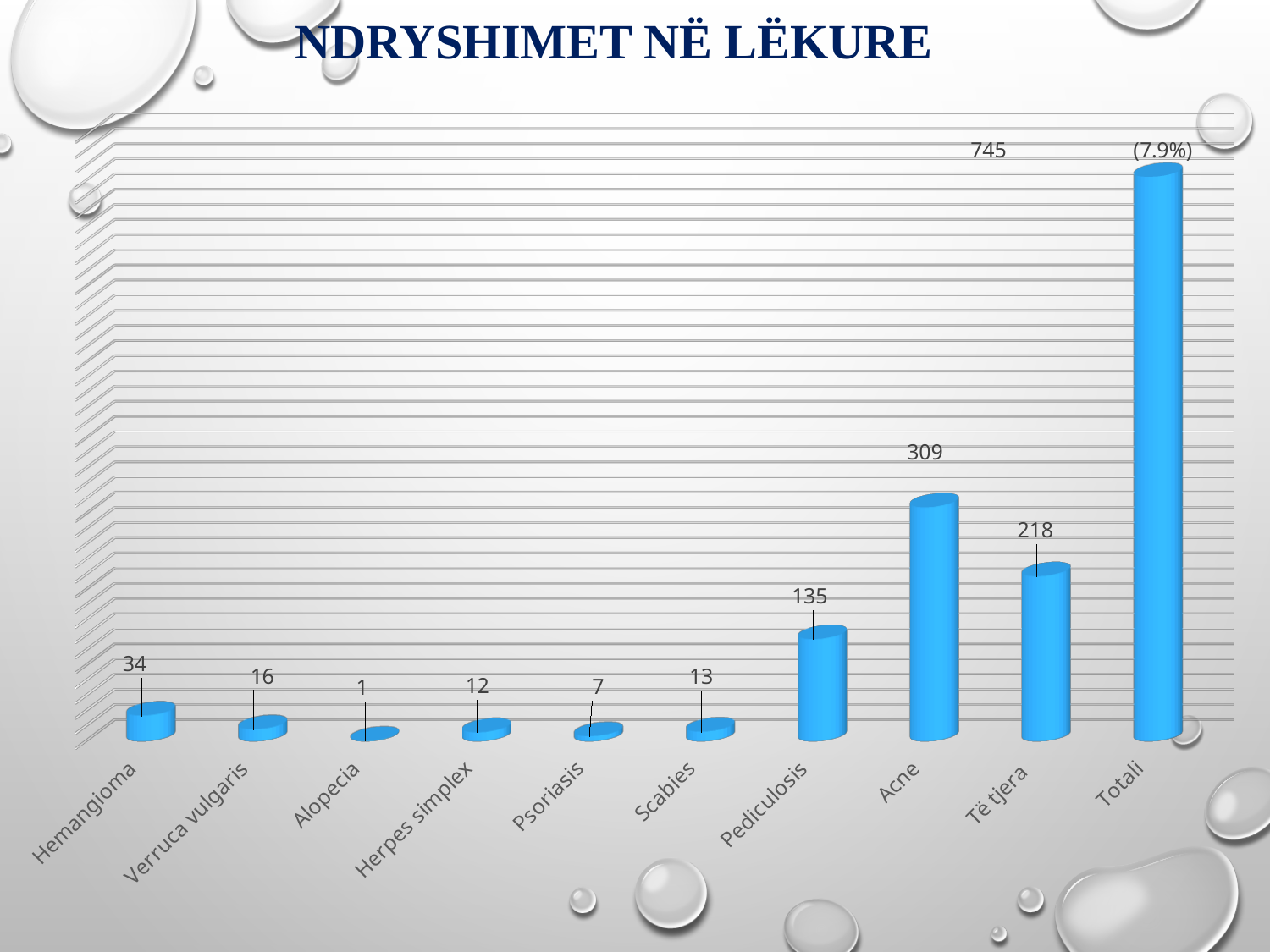
What is the value for Acne? 309 What is the value for Scabies? 13 What is the difference between the values for Acne and Të tjera? 91 How many categories are shown on the x axis? 10 Which is larger, the value for Verruca vulgaris or the value for Herpes simplex? Verruca vulgaris What is the title of the slide? NDRYSHIMET NË LËKURE What is the value for Pediculosis? 135 What is the value for Të tjera? 218 What is the value for Hemangioma? 34 Which category has the highest value? Totali What kind of chart is shown on the slide? Bar chart Which category has the lowest value? Alopecia